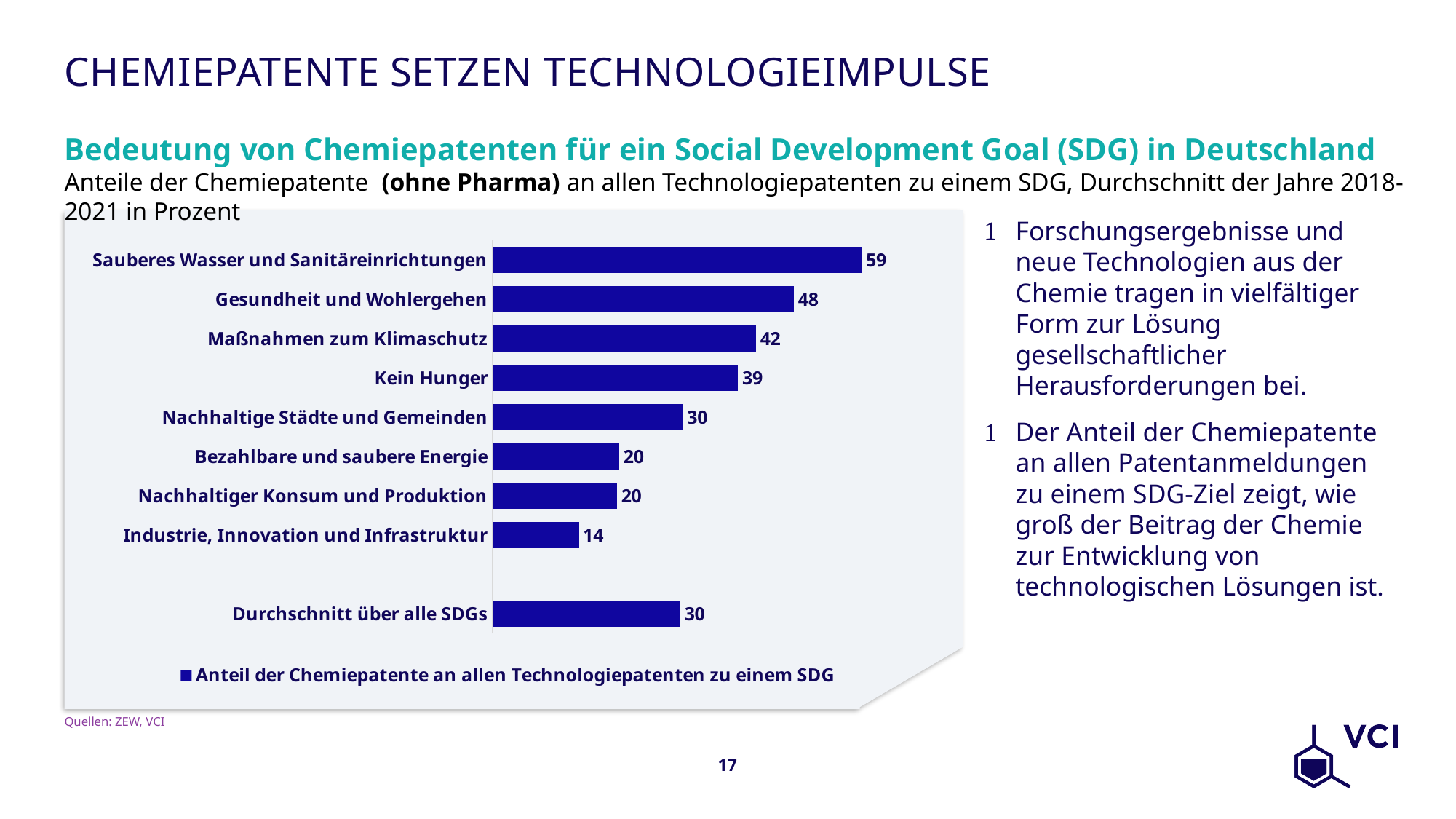
What kind of chart is shown on the slide? Bar chart Which category has the highest value? Sauberes Wasser und Sanitäreinrichtungen What is the legend entry of the chart? Anteil der Chemiepatente an allen Technologiepatenten zu einem SDG What is the value for Sauberes Wasser und Sanitäreinrichtungen? 59 What is the difference between Sauberes Wasser und Sanitäreinrichtungen and Industrie, Innovation und Infrastruktur? 45 Which is larger: Nachhaltige Städte und Gemeinden or Bezahlbare und saubere Energie? Nachhaltige Städte und Gemeinden How many series does the legend list? 1 Which category has the lowest value? Industrie, Innovation und Infrastruktur What is the value for Durchschnitt über alle SDGs? 30 What is the value for Kein Hunger? 39 What is the difference between Gesundheit und Wohlergehen and Maßnahmen zum Klimaschutz? 6 How many bars are shown in the chart? 9